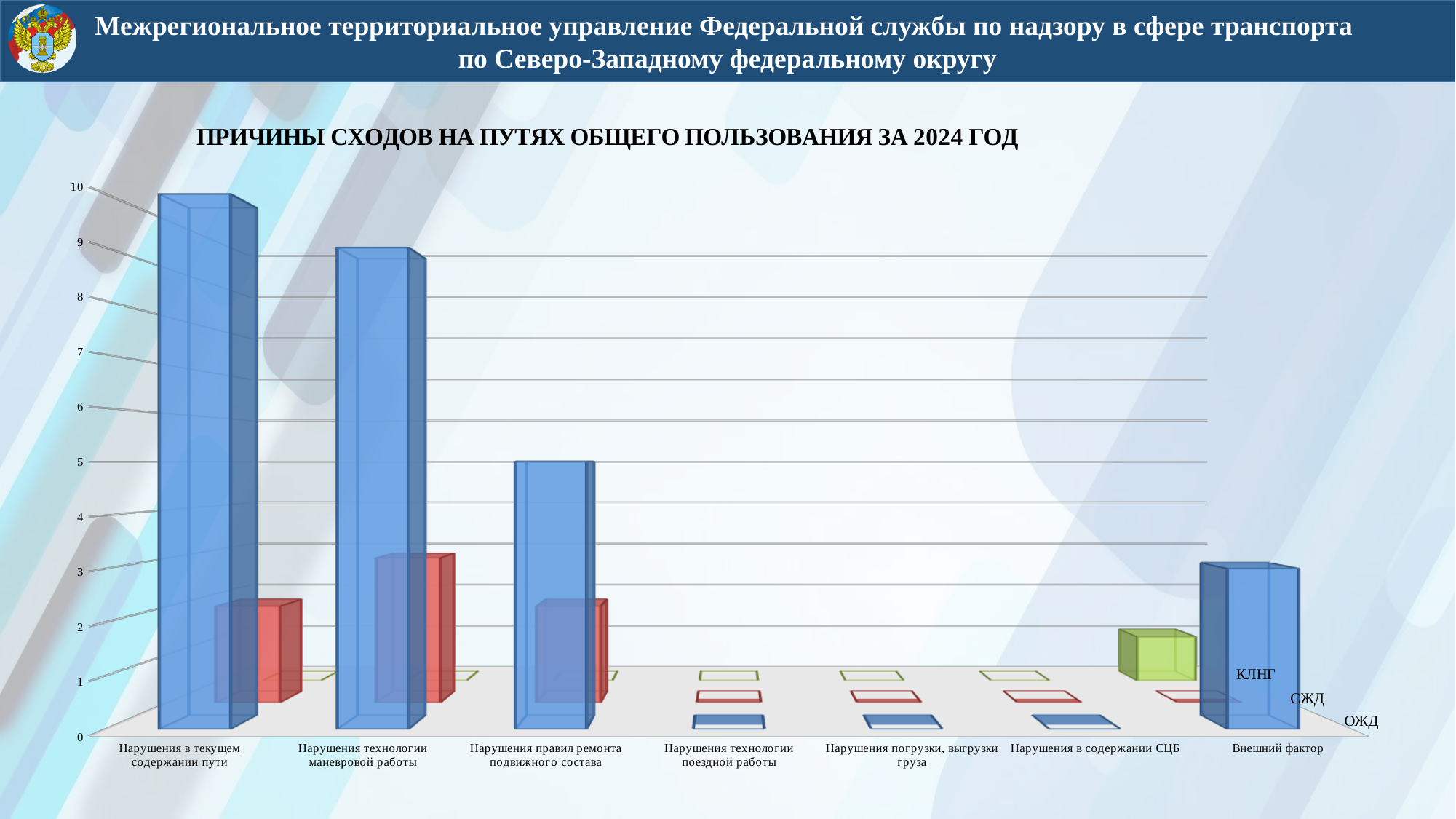
What kind of chart is shown on the slide? bar chart Is the ОЖД value for Нарушения в текущем содержании пути greater or less than 8? greater For the ОЖД series, which is larger: Нарушения правил ремонта подвижного состава or Внешний фактор? Нарушения правил ремонта подвижного состава Is the ОЖД value for Нарушения технологии маневровой работы greater or less than 7? greater Is the ОЖД value for Внешний фактор greater or less than 2? greater How many categories are shown along the x axis of the chart? 7 Which category has the highest value for the ОЖД series? Нарушения в текущем содержании пути What is the title of the chart? ПРИЧИНЫ СХОДОВ НА ПУТЯХ ОБЩЕГО ПОЛЬЗОВАНИЯ ЗА 2024 ГОД